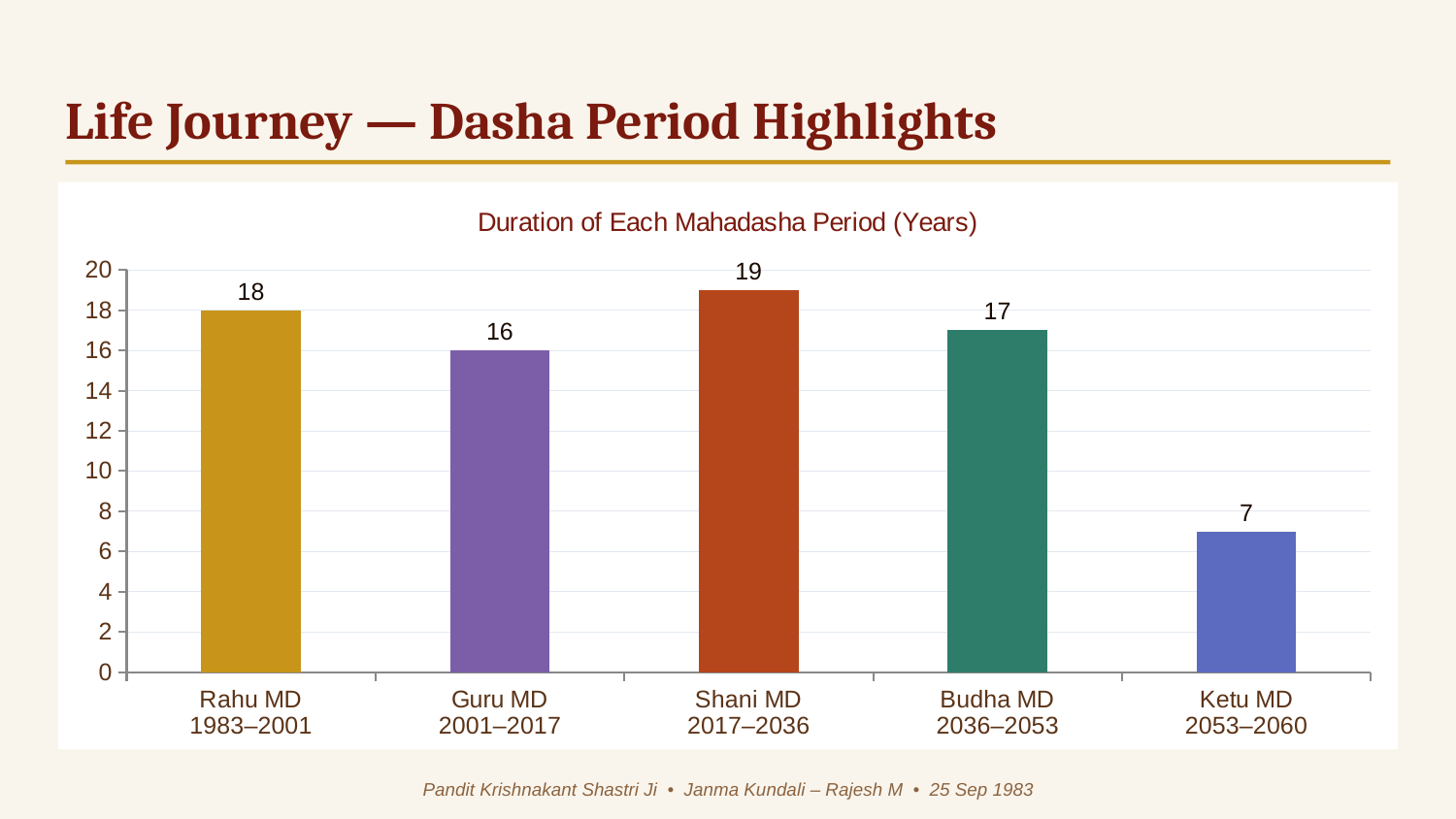
What is the difference in years between the Rahu MD and Ketu MD durations? 11 What is the duration of the Shani MD period in years? 19 Which Mahadasha period has the longest duration? Shani MD Which Mahadasha period has the shortest duration? Ketu MD What kind of chart is shown on the slide? Bar chart What is the duration of the Guru MD period in years? 16 Which period is longer, Budha MD or Guru MD? Budha MD What is the title of the chart? Duration of Each Mahadasha Period (Years) How many Mahadasha periods are shown in the chart? 5 What is the duration of the Ketu MD period in years? 7 Is the value for Ketu MD greater or less than 10? less What years does the Budha MD period cover according to the axis label? 2036–2053